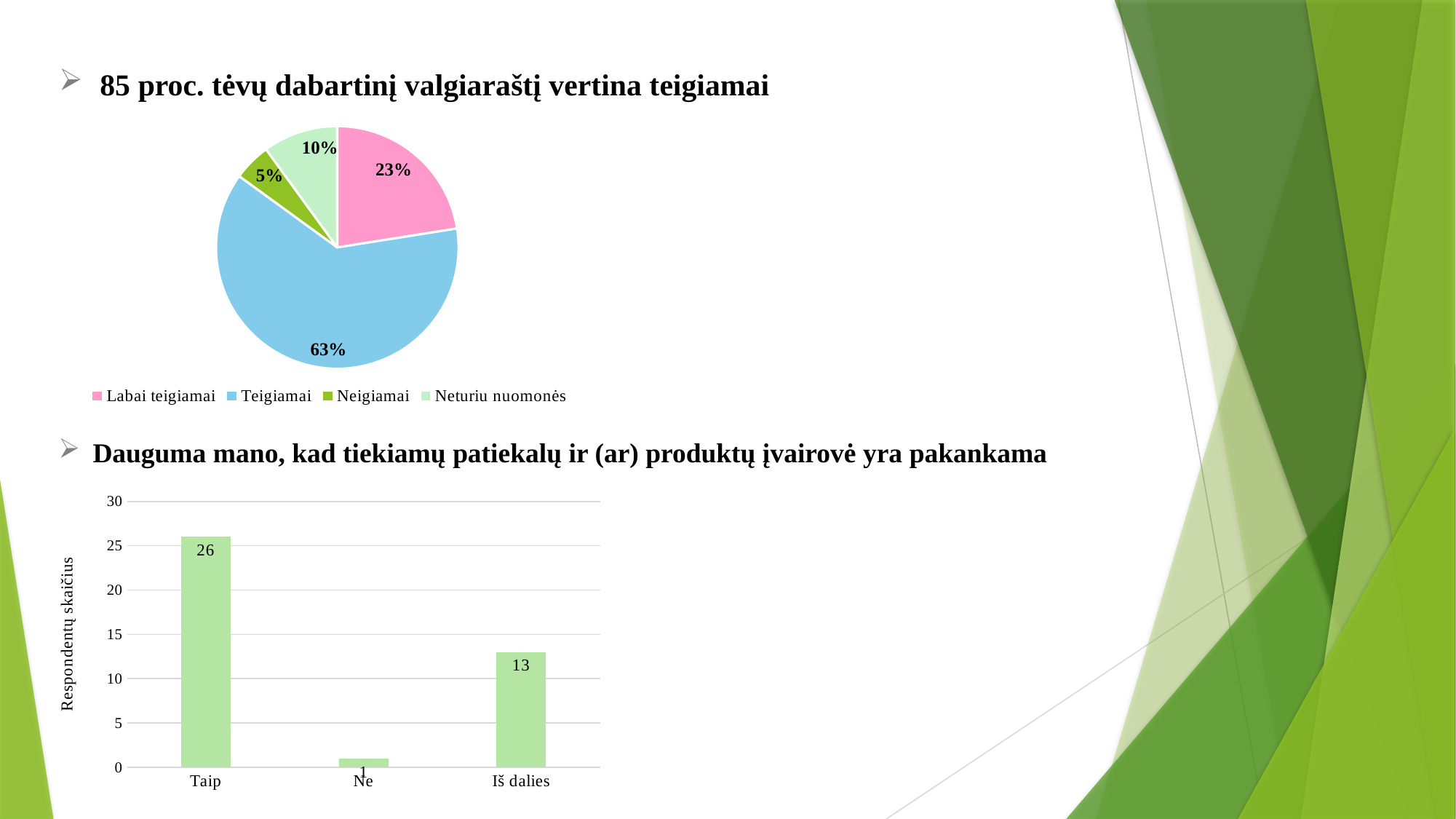
In the pie chart at the top of the slide, which category has the smallest slice? Neigiamai In the pie chart at the top of the slide, what share is labelled for Teigiamai? 63% In the bar chart at the bottom of the slide, what is the value for Iš dalies? 13 In the pie chart at the top of the slide, what share is labelled for Labai teigiamai? 23% What kind of chart is the chart at the bottom of the slide? Bar chart How many categories does the legend of the pie chart at the top of the slide list? 4 In the bar chart at the bottom of the slide, which category has the lowest value? Ne In the bar chart at the bottom of the slide, what is the difference between the values for Taip and Iš dalies? 13 In the bar chart at the bottom of the slide, what is the value for Taip? 26 In the pie chart at the top of the slide, what is the difference between the Teigiamai and Labai teigiamai shares? 40% In the pie chart at the top of the slide, what colour is the Neturiu nuomonės slice? Light green In the pie chart at the top of the slide, which category has the largest slice? Teigiamai